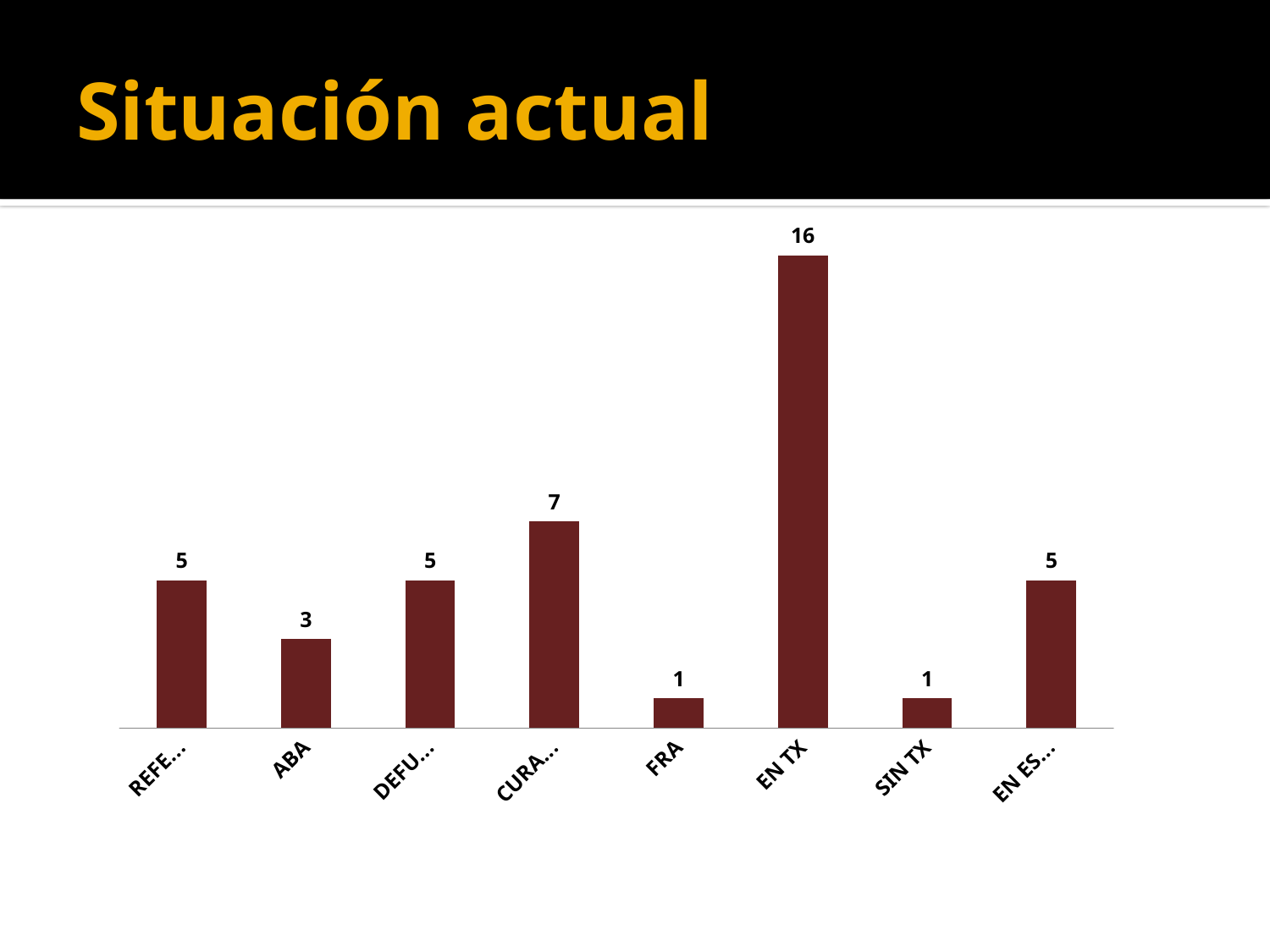
What is the difference between the EN TX value and the SIN TX value? 15 What is the value of the FRA bar? 1 Which is larger, the value for ABA or the value for FRA? ABA Which categories share the lowest value? FRA and SIN TX What kind of chart is shown on the slide? Bar chart What is the title of the slide? Situación actual How many bars are shown in the chart? 8 Which category has the highest value? EN TX What is the value of the ABA bar? 3 What is the value of the SIN TX bar? 1 What is the value of the EN TX bar? 16 What is the difference between the EN TX value and the ABA value? 13